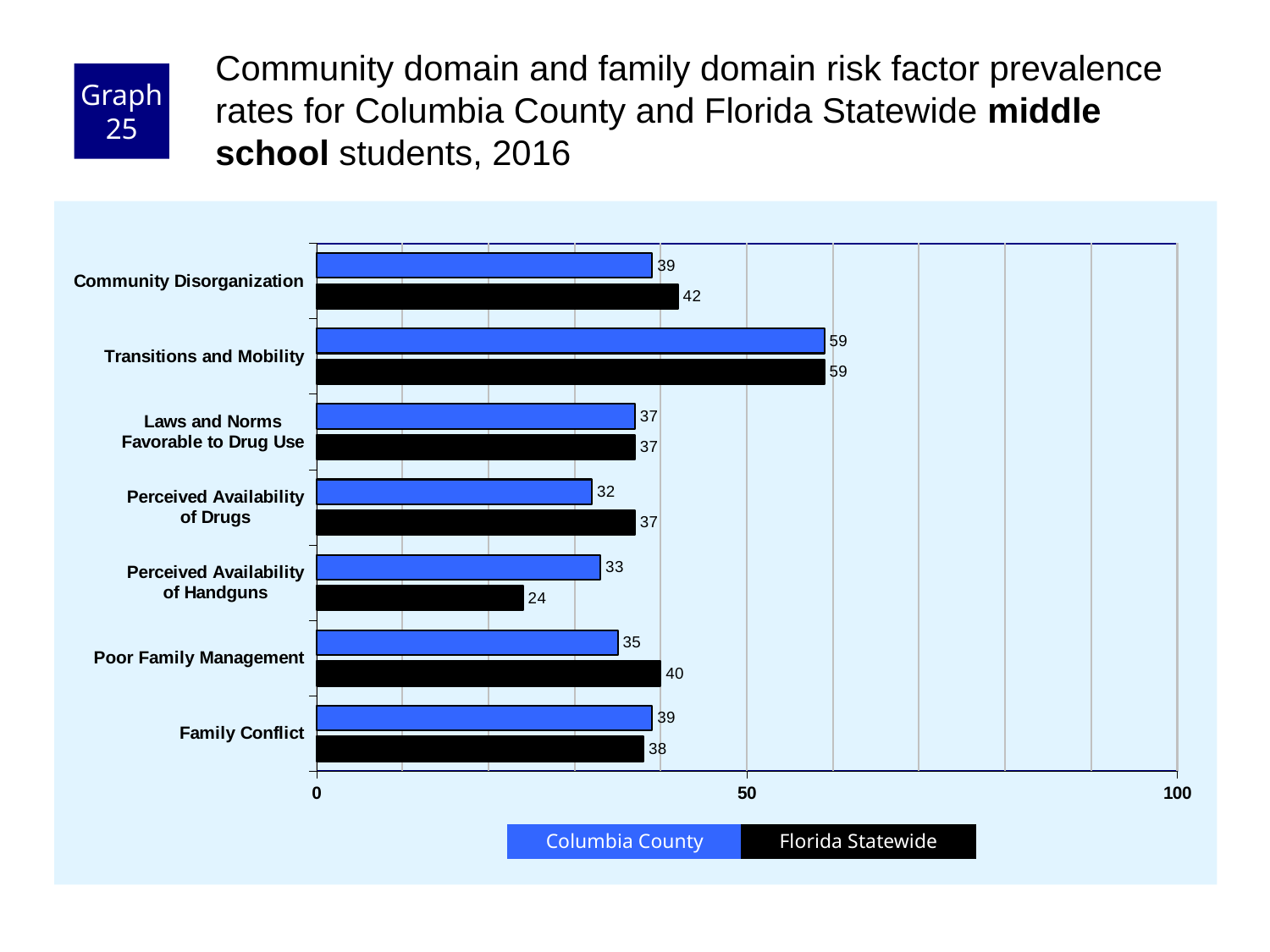
What is the Florida Statewide value for Perceived Availability of Handguns? 24 Which risk factor has the lowest Florida Statewide value? Perceived Availability of Handguns What is the Florida Statewide value for Poor Family Management? 40 Which risk factor has the highest Columbia County value? Transitions and Mobility Is the Columbia County value for Transitions and Mobility greater or less than 50? greater How many risk factor categories are shown on the chart? 7 What kind of chart is shown on the slide? bar chart What is the Columbia County value for Perceived Availability of Drugs? 32 What is the difference between the Florida Statewide and Columbia County values for Perceived Availability of Handguns? 9 How many series does the legend list? 2 What is the difference between the Florida Statewide and Columbia County values for Community Disorganization? 3 For Poor Family Management, which is larger: the Columbia County value or the Florida Statewide value? Florida Statewide